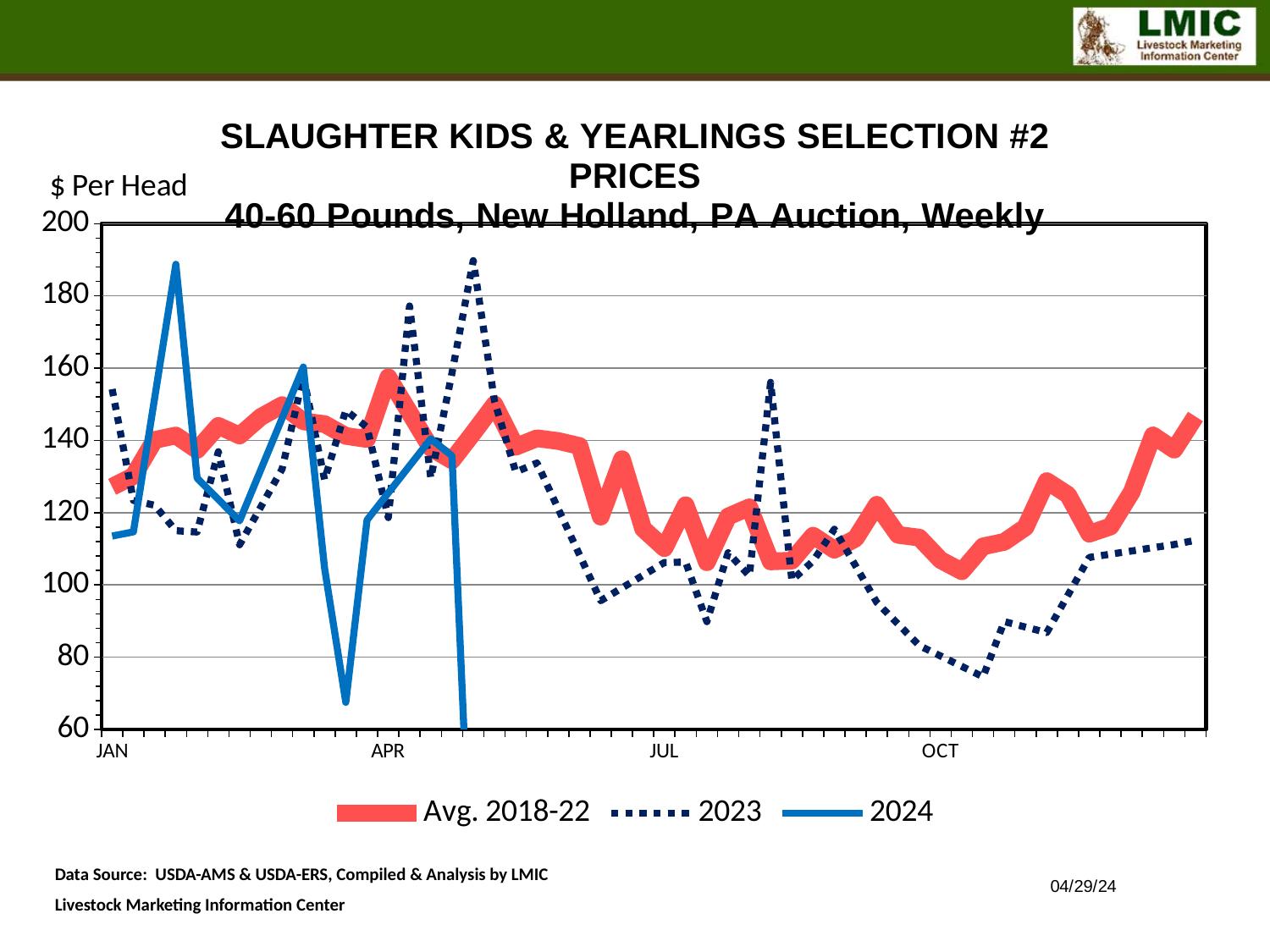
How many month labels are shown on the x axis? 4 Does the 2023 series generally rise or fall between July and October? fall Is the lowest value of the 2023 series around October greater or less than 80? less Which series is drawn as a dotted line in the legend? 2023 Is the value of the 2023 series at the start of July greater or less than 100? greater What is the label on the vertical axis of the chart? $ Per Head Is the value of the Avg. 2018-22 series at the start of January greater or less than 120? greater How many series does the legend list? 3 At the start of January, which is larger: the Avg. 2018-22 value or the 2024 value? Avg. 2018-22 What kind of chart is shown on the slide? line chart